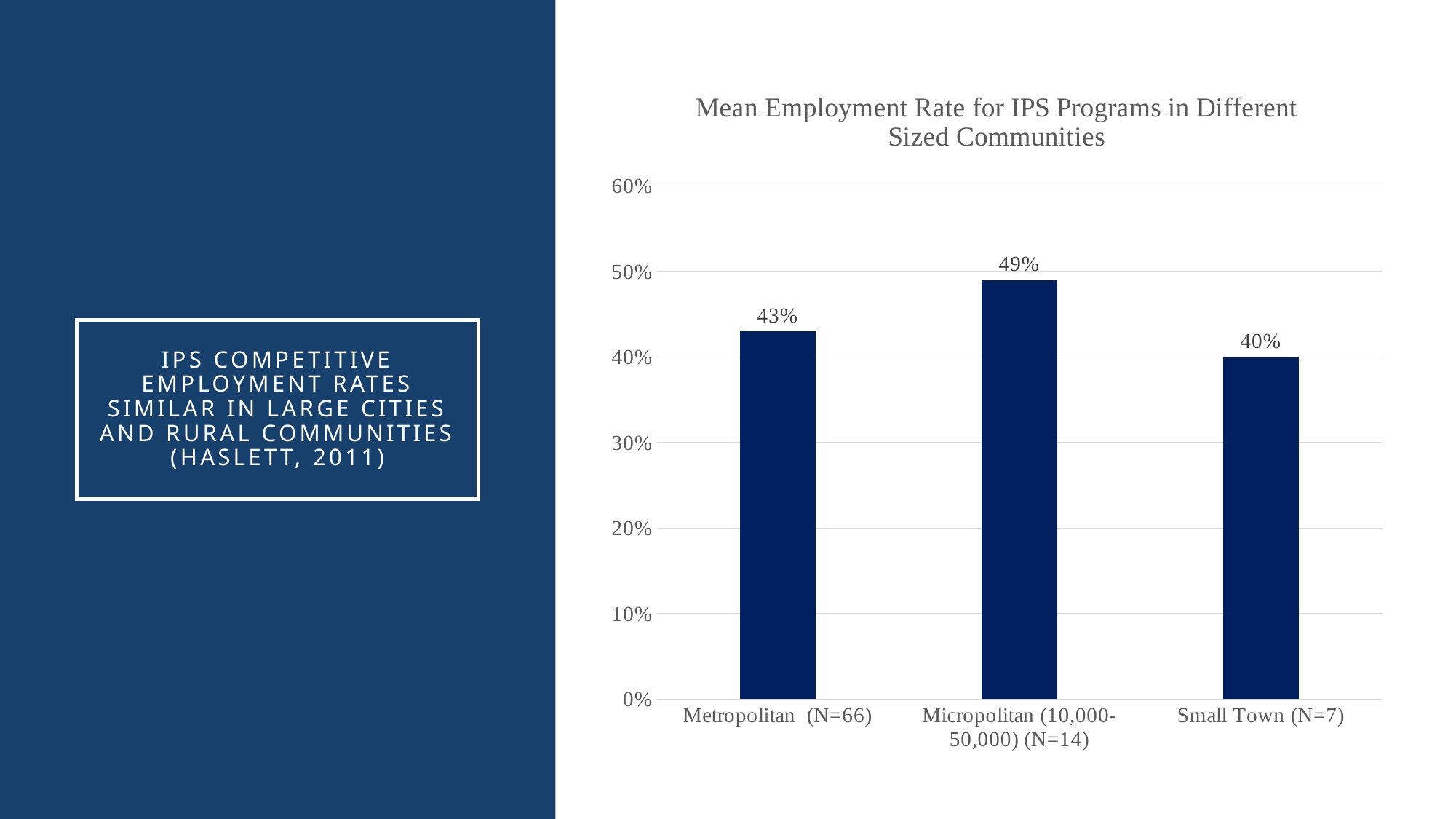
What is the difference between the mean employment rates for Micropolitan and Metropolitan programs? 6% What is the mean employment rate for Micropolitan (10,000-50,000) (N=14) programs? 49% Which has a higher mean employment rate, Metropolitan or Small Town? Metropolitan Which community size has the highest mean employment rate? Micropolitan (10,000-50,000) (N=14) What is the mean employment rate for Metropolitan (N=66) programs? 43% Is the value for Micropolitan greater or less than 50%? less What is the mean employment rate for Small Town (N=7) programs? 40% How many community size categories are shown in the chart? 3 What is the title of the chart? Mean Employment Rate for IPS Programs in Different Sized Communities Which community size has the lowest mean employment rate? Small Town (N=7) What kind of chart is shown on the slide? Bar chart What is the difference between the mean employment rates for Micropolitan and Small Town programs? 9%